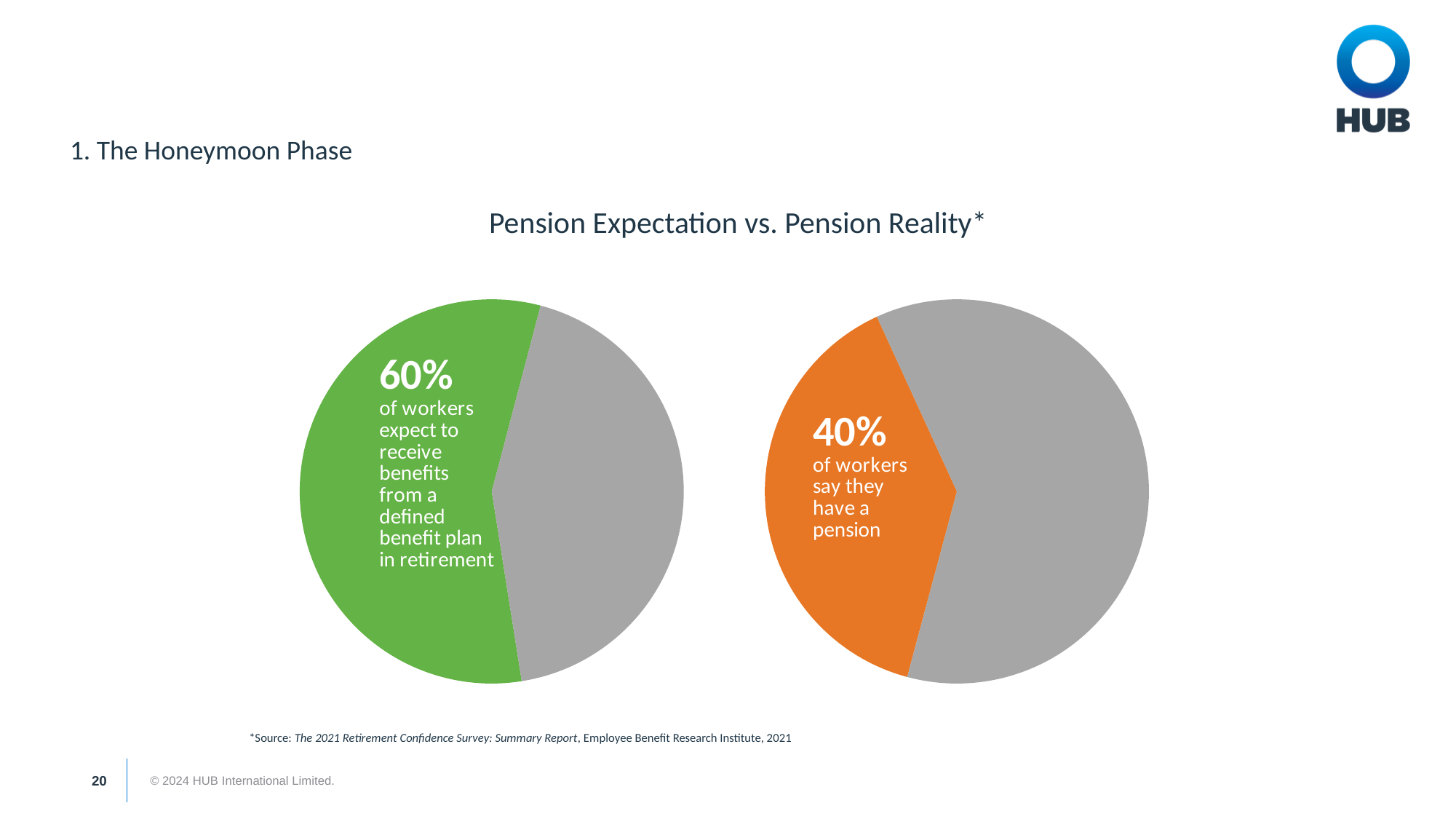
In the left pie chart, what percentage of workers expect to receive benefits from a defined benefit plan in retirement? 60% By how many percentage points does the share of workers expecting defined benefit plan benefits (left pie) exceed the share who say they have a pension (right pie)? 20 percentage points How many slices does the right pie chart have? 2 What is the title above the two pie charts? Pension Expectation vs. Pension Reality* In the right pie chart, what percentage of workers say they have a pension? 40% What colour is the slice representing the 60% of workers in the left pie chart? Green How many slices does the left pie chart have? 2 Which is larger: the share of workers who expect to receive defined benefit plan benefits (left pie) or the share who say they have a pension (right pie)? Workers who expect to receive defined benefit plan benefits (60%) What kind of charts are shown on the slide? Pie charts In the right pie chart, is the orange slice greater or less than half of the pie? less In the left pie chart, is the labelled slice greater or less than half of the pie? greater